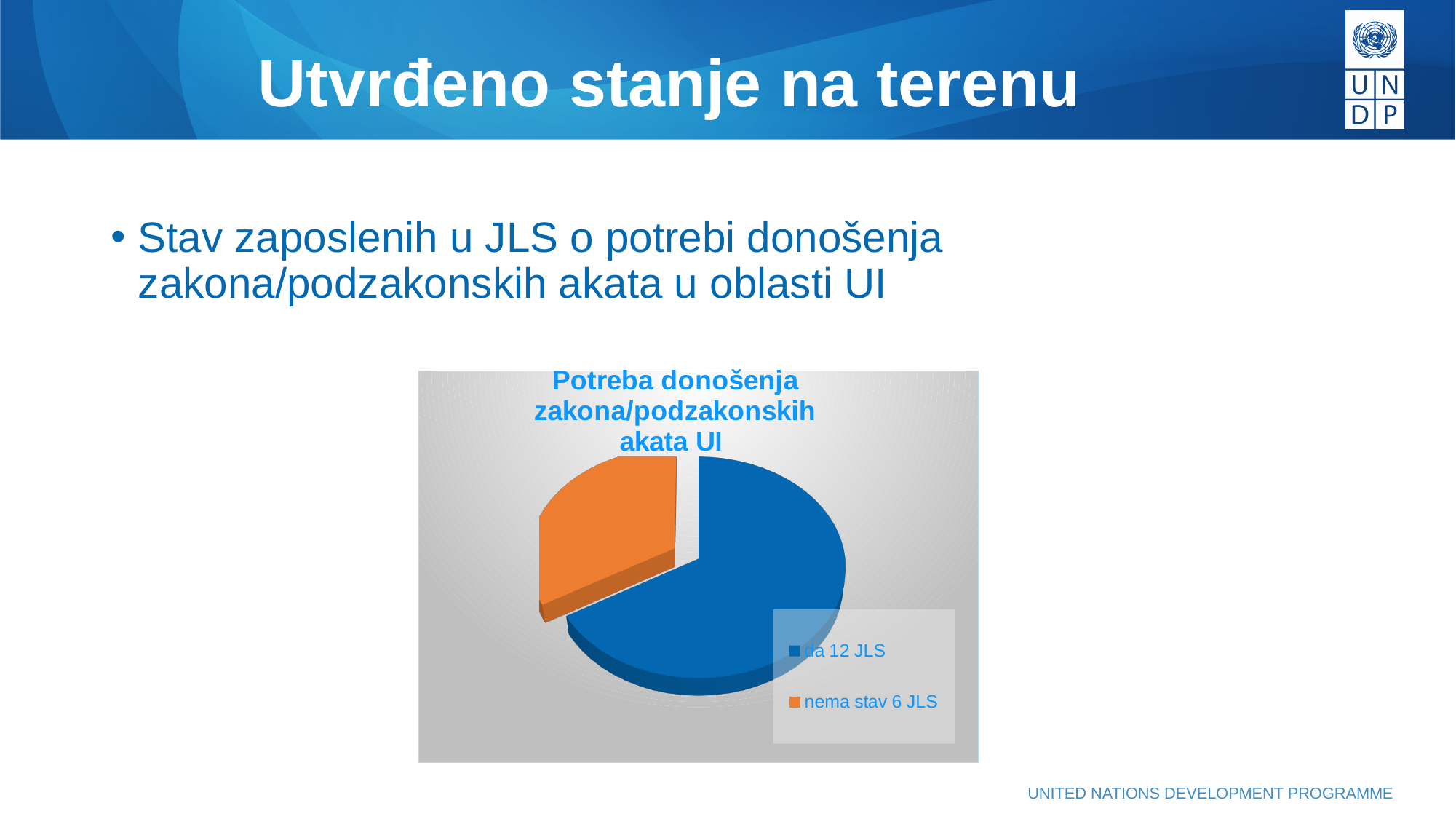
How many JLS are in the "nema stav" category according to the legend? 6 JLS What is the difference in the number of JLS between "da" and "nema stav"? 6 How many slices does the pie chart have? 2 Which category has the largest slice of the pie? da How many JLS answered "da" according to the legend? 12 JLS Which category has more JLS, "da" or "nema stav"? da What colour is the "nema stav" slice? orange How many entries does the chart legend list? 2 Which category has the smallest slice of the pie? nema stav What is the title of the chart? Potreba donošenja zakona/podzakonskih akata UI What kind of chart is shown on the slide? pie chart